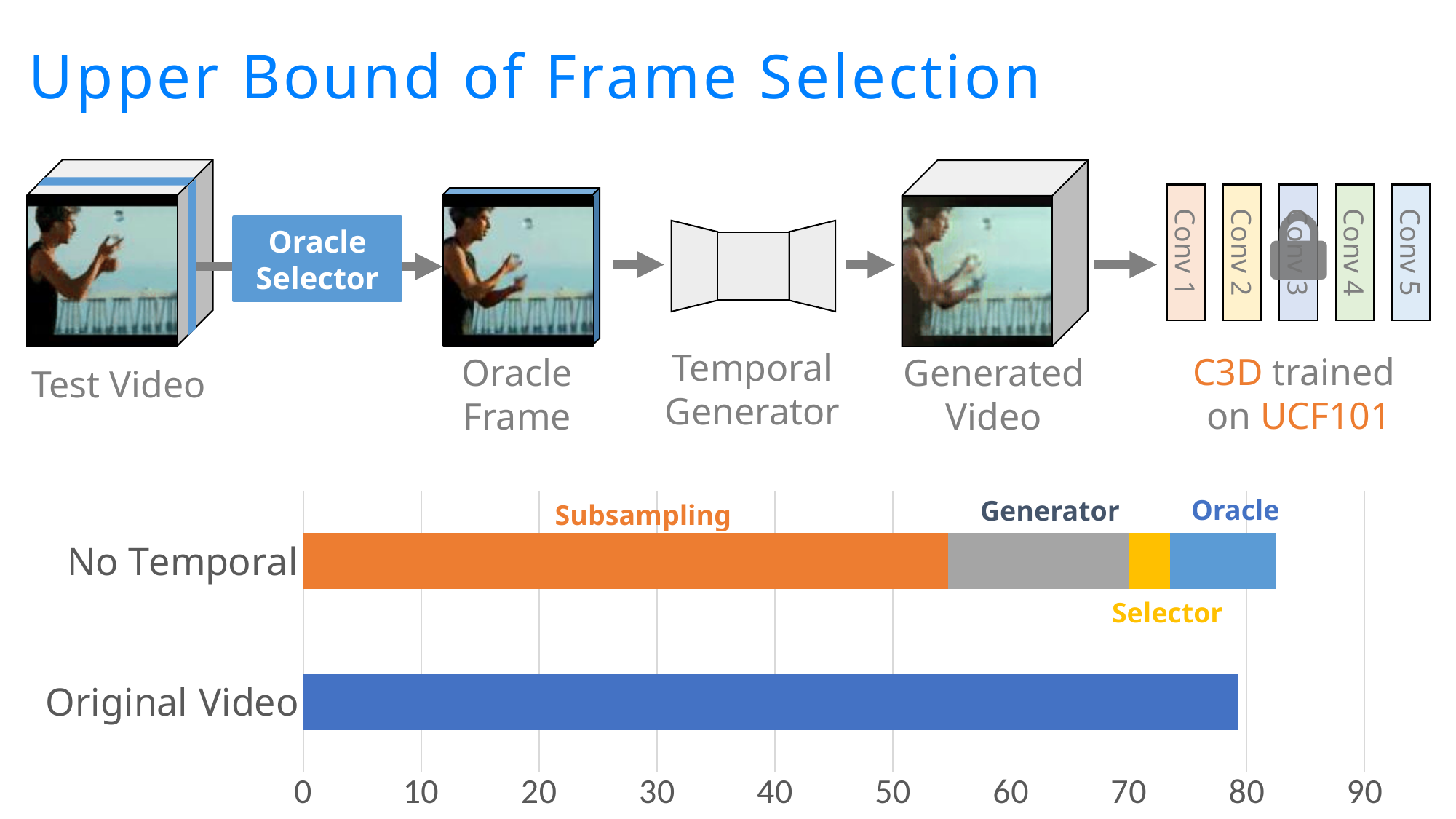
Which segment of the No Temporal bar is the largest? Subsampling Is the value for Original Video greater or less than 70? greater What is the highest tick value shown on the horizontal axis? 90 Is the Subsampling segment of the No Temporal bar greater or less than 50? greater Which bar extends further along the x axis, No Temporal or Original Video? No Temporal Is the total length of the No Temporal bar greater or less than 70? greater How many categories are shown on the vertical axis of the chart? 2 Which segment of the No Temporal bar is coloured orange? Subsampling What kind of chart is shown on the slide? bar chart Which segment of the No Temporal bar is the smallest? Selector How many labelled segments make up the No Temporal bar? 4